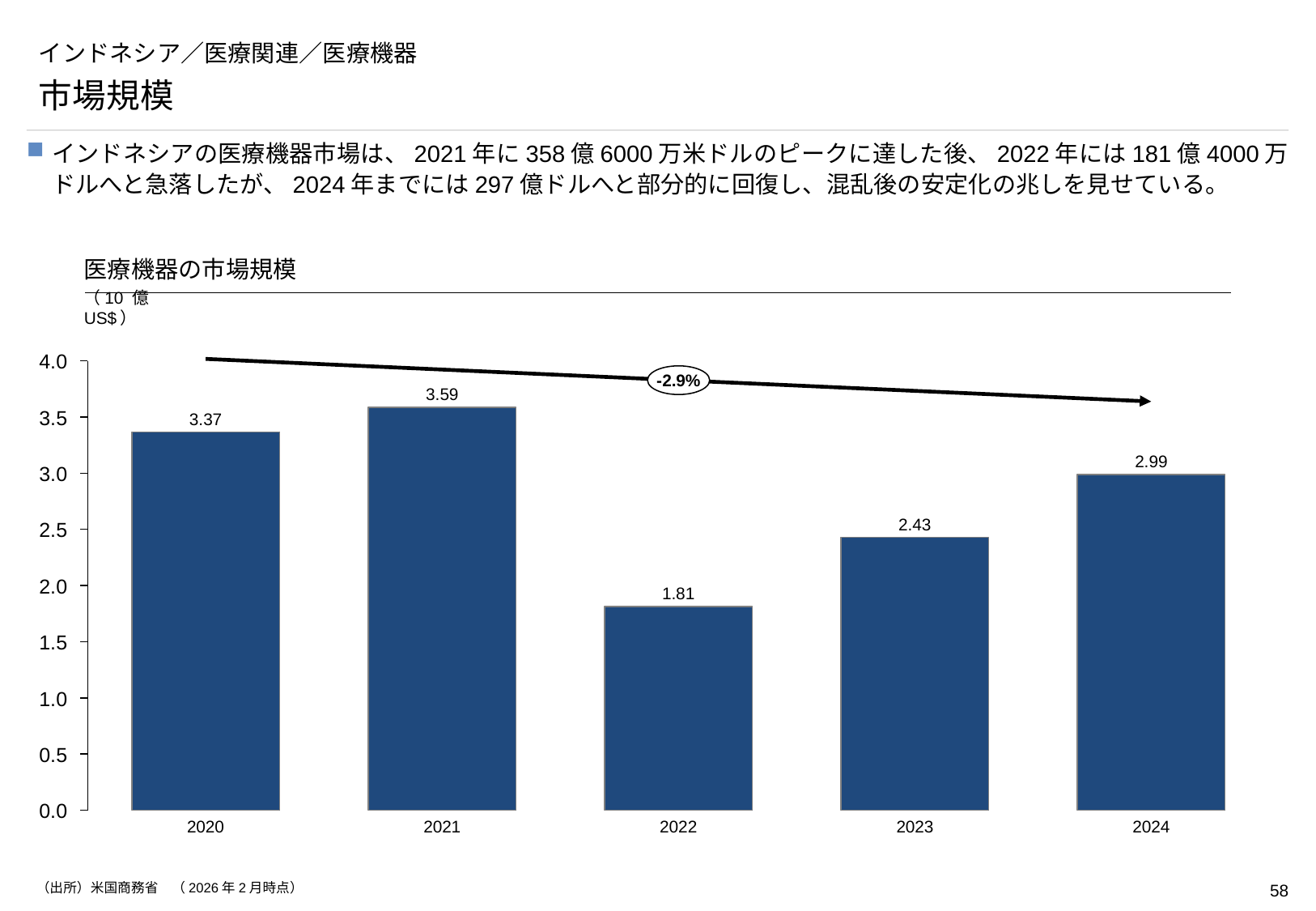
What is the difference between the values for 2024 and 2023? 0.56 Which year has the lowest value? 2022 What kind of chart is this? bar chart What percentage is shown in the label on the arrow above the bars? -2.9% Is the value for 2023 greater or less than 2.5? less What is the value for 2021? 3.59 Which year has the highest value? 2021 How many years are shown on the x axis? 5 What is the difference between the values for 2021 and 2022? 1.78 What is the value for 2024? 2.99 What is the value for 2022? 1.81 Which is larger, the value for 2020 or the value for 2024? 2020